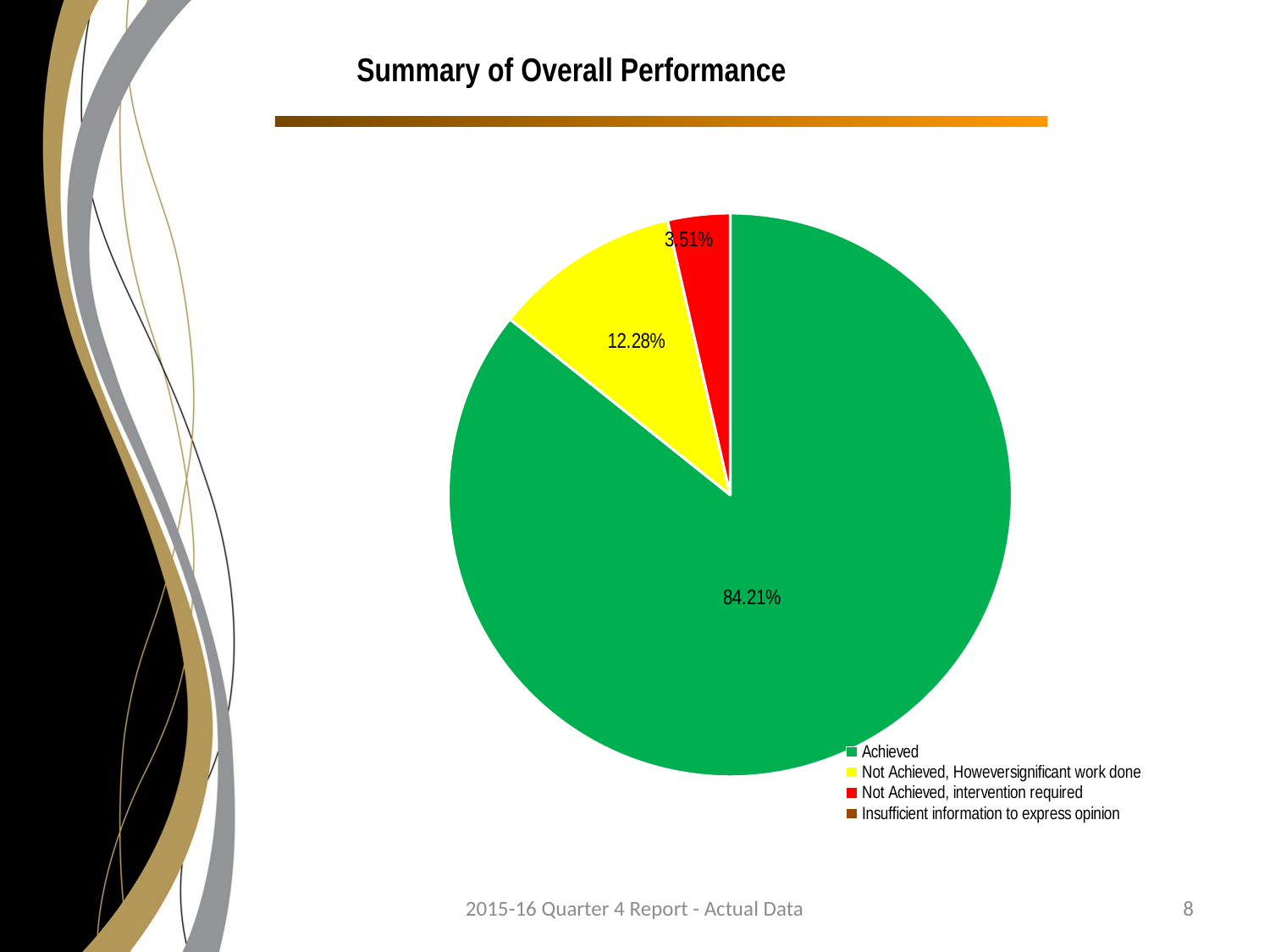
What is the difference between the Achieved share and the 'Not Achieved, However significant work done' share? 71.93% What colour is the Achieved slice? green How many entries does the legend list? 4 What percentage is shown for the 'Not Achieved, intervention required' slice? 3.51% Which of the labelled slices is the smallest? Not Achieved, intervention required What percentage is shown for the 'Not Achieved, However significant work done' slice? 12.28% What is the title of the slide containing the chart? Summary of Overall Performance Which is larger: the 'Not Achieved, However significant work done' slice or the 'Not Achieved, intervention required' slice? Not Achieved, However significant work done Which category has the largest slice of the pie? Achieved What kind of chart is shown on the slide? pie chart What share of the pie is labelled for the Achieved slice? 84.21% How many slices with percentage labels are visible in the pie? 3